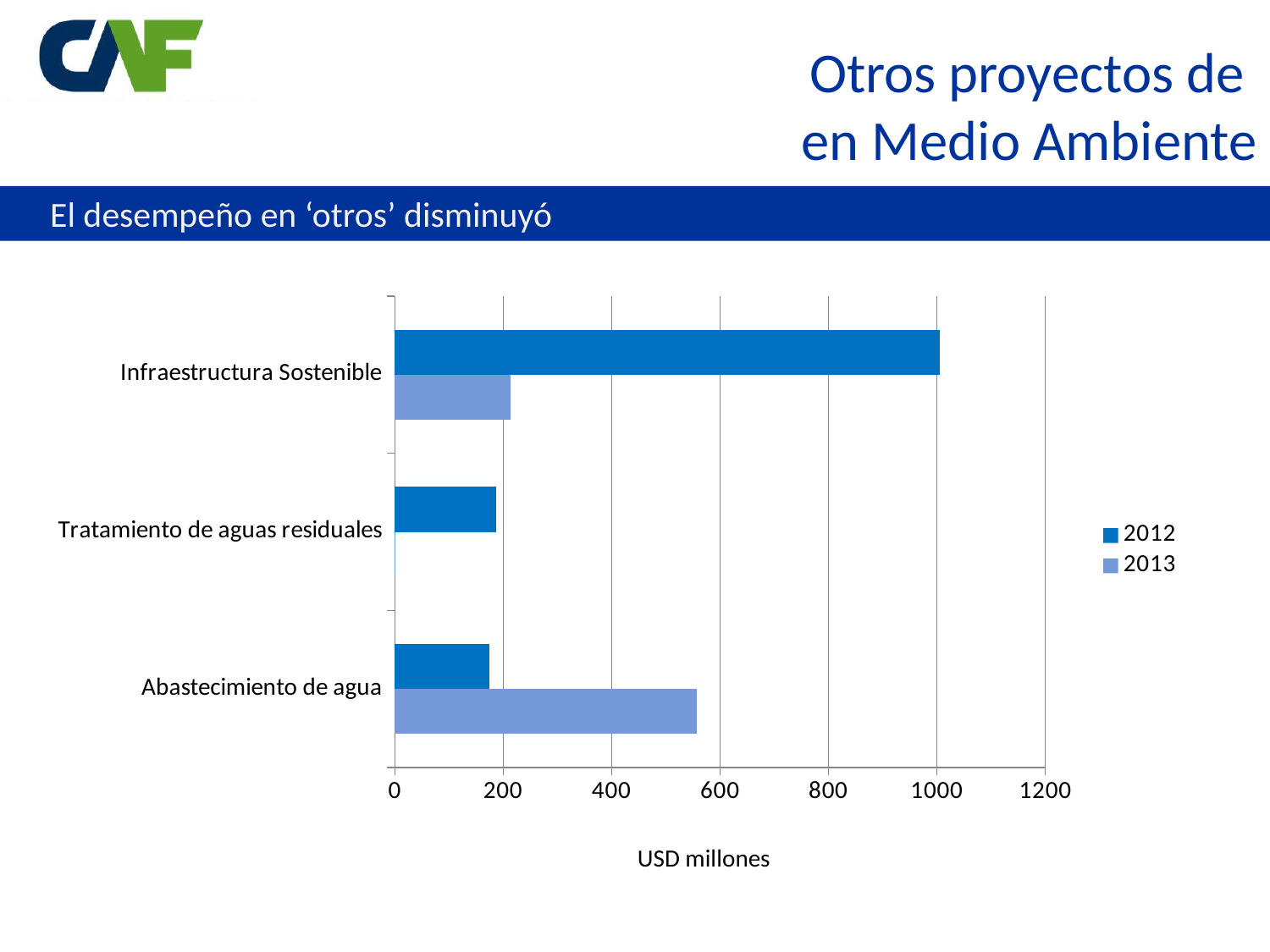
For Abastecimiento de agua, which year has the larger value, 2012 or 2013? 2013 Which category has the highest value for 2013? Abastecimiento de agua How many categories are shown on the chart? 3 What is the label on the horizontal axis of the chart? USD millones Is the 2013 value for Abastecimiento de agua greater or less than 400? greater Is the 2012 value for Infraestructura Sostenible greater or less than 800? greater For Infraestructura Sostenible, which year has the larger value, 2012 or 2013? 2012 Which category has the highest value for 2012? Infraestructura Sostenible What kind of chart is shown on the slide? Bar chart Is the 2012 value for Tratamiento de aguas residuales greater or less than 400? less How many series does the legend list? 2 Which category has the lowest value for 2013? Tratamiento de aguas residuales